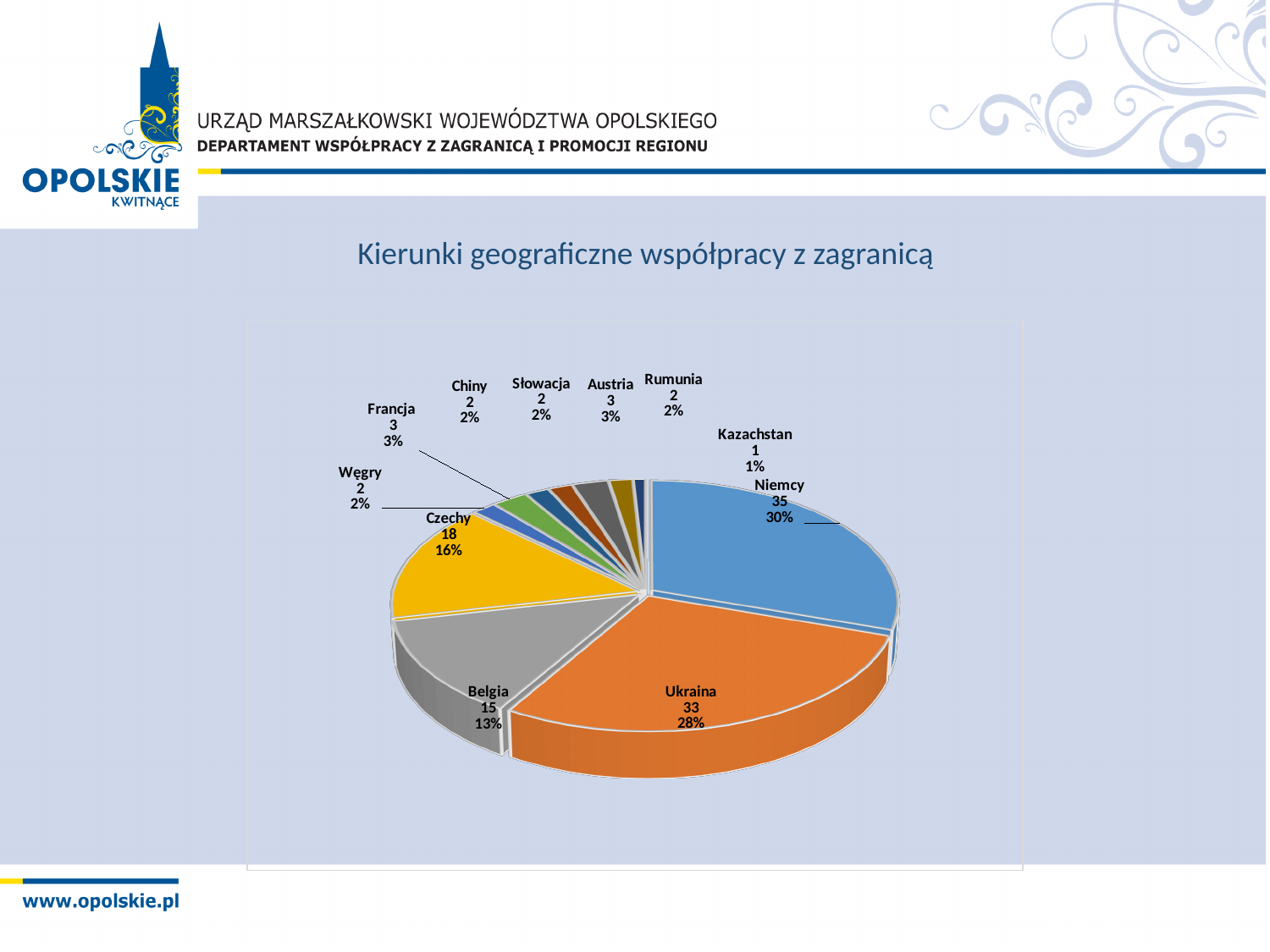
What is the value shown for Niemcy? 35 What is the difference between the values for Niemcy and Ukraina? 2 What is the title of the chart? Kierunki geograficzne współpracy z zagranicą What percentage share does Belgia have? 13% What is the value shown for Austria? 3 Which country has the smallest slice of the pie? Kazachstan Which country has the largest slice of the pie? Niemcy How many categories (countries) does the pie chart show? 11 Which is larger, the value for Czechy or the value for Belgia? Czechy What percentage share does Ukraina have in the pie chart? 28% What is the value shown for Czechy? 18 What kind of chart is shown on the slide? pie chart